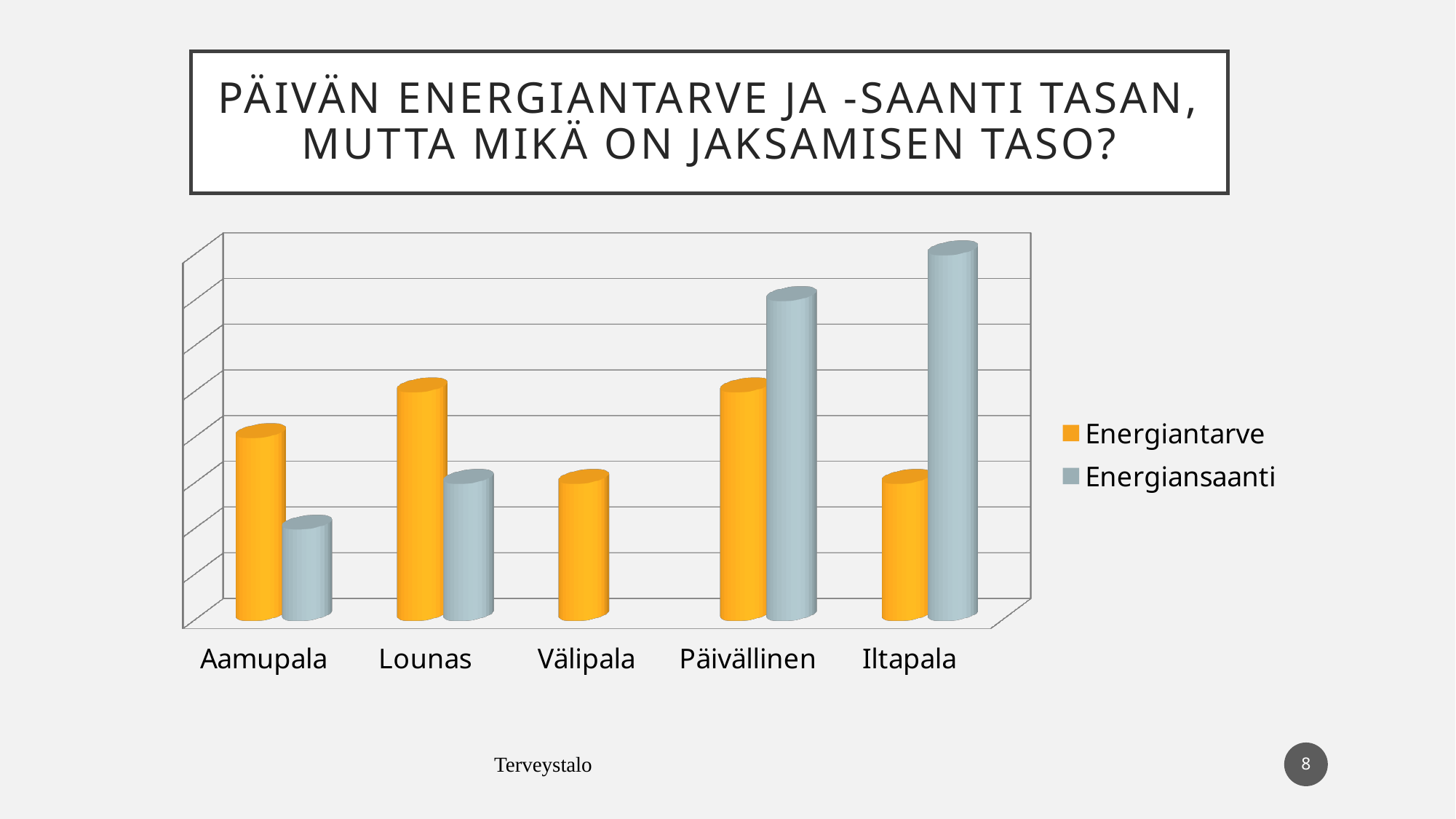
Which series is shown in orange in the chart? Energiantarve How many series does the chart legend list? 2 For Iltapala, which is larger: Energiantarve or Energiansaanti? Energiansaanti Which category has a higher Energiansaanti value: Päivällinen or Aamupala? Päivällinen Which category has the lowest Energiansaanti value? Aamupala For Päivällinen, which is larger: Energiantarve or Energiansaanti? Energiansaanti What kind of chart is shown on the slide? bar chart Which category has the highest Energiansaanti value? Iltapala How many categories are shown on the x axis of the chart? 5 Which series is shown in grey-blue in the chart? Energiansaanti